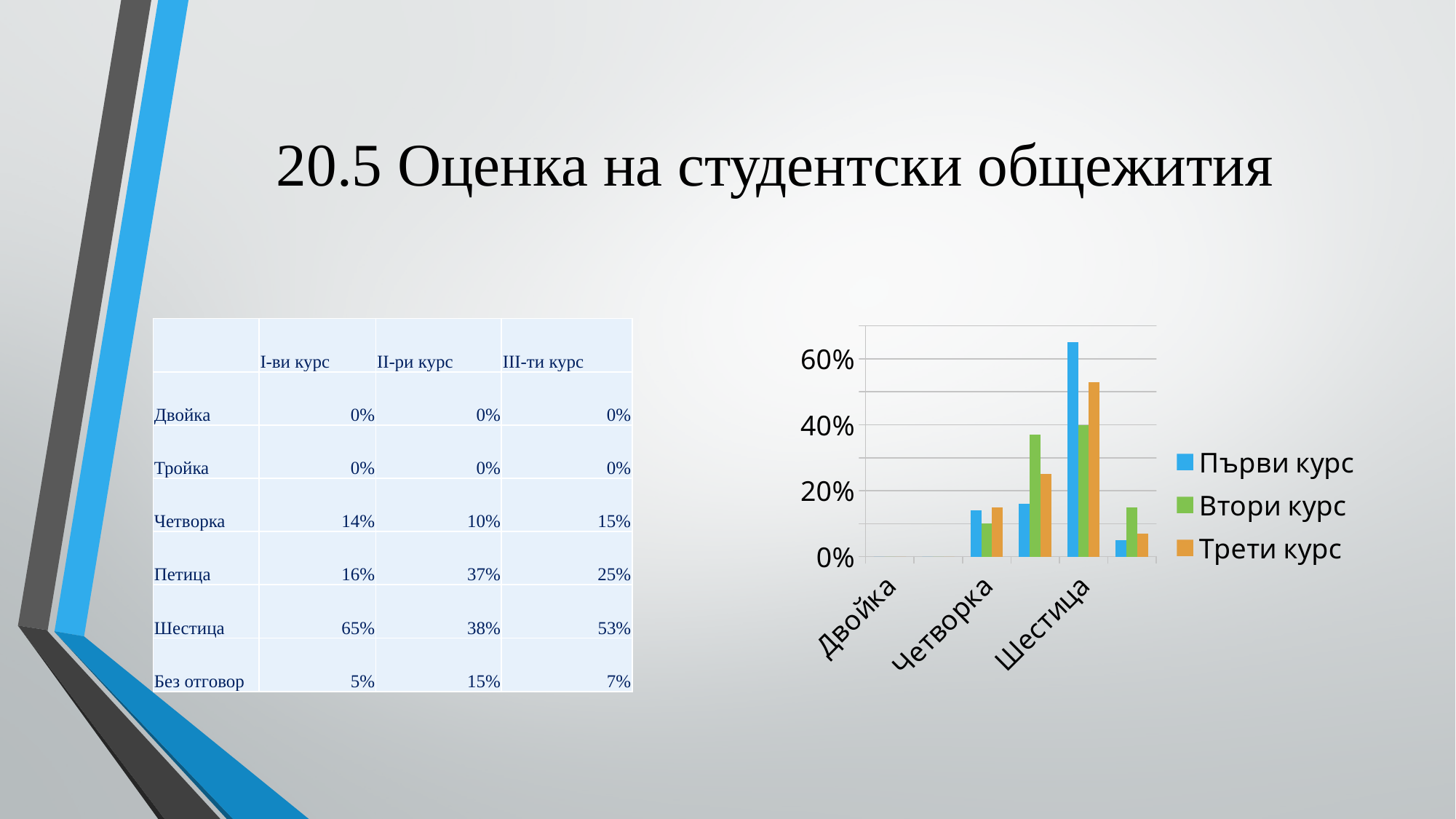
What kind of chart is shown on the slide? bar chart According to the table on the slide, what is the value of III-ти курс for Шестица? 53% Which series has the lowest bar for Шестица? Втори курс According to the table on the slide, what is the value of II-ри курс for Петица? 37% Using the table values, what is the difference between I-ви курс and II-ри курс for Шестица? 27% What are the three series named in the chart's legend? Първи курс, Втори курс, Трети курс For Четворка, which is larger: Първи курс or Втори курс? Първи курс How many series does the chart's legend list? 3 In the chart, is the value of Втори курс for Четворка greater or less than 20%? less In the chart, is the value of Първи курс for Шестица greater or less than 60%? greater In the chart, is the value of Трети курс for Шестица greater or less than 40%? greater Which series has the highest bar for Шестица? Първи курс